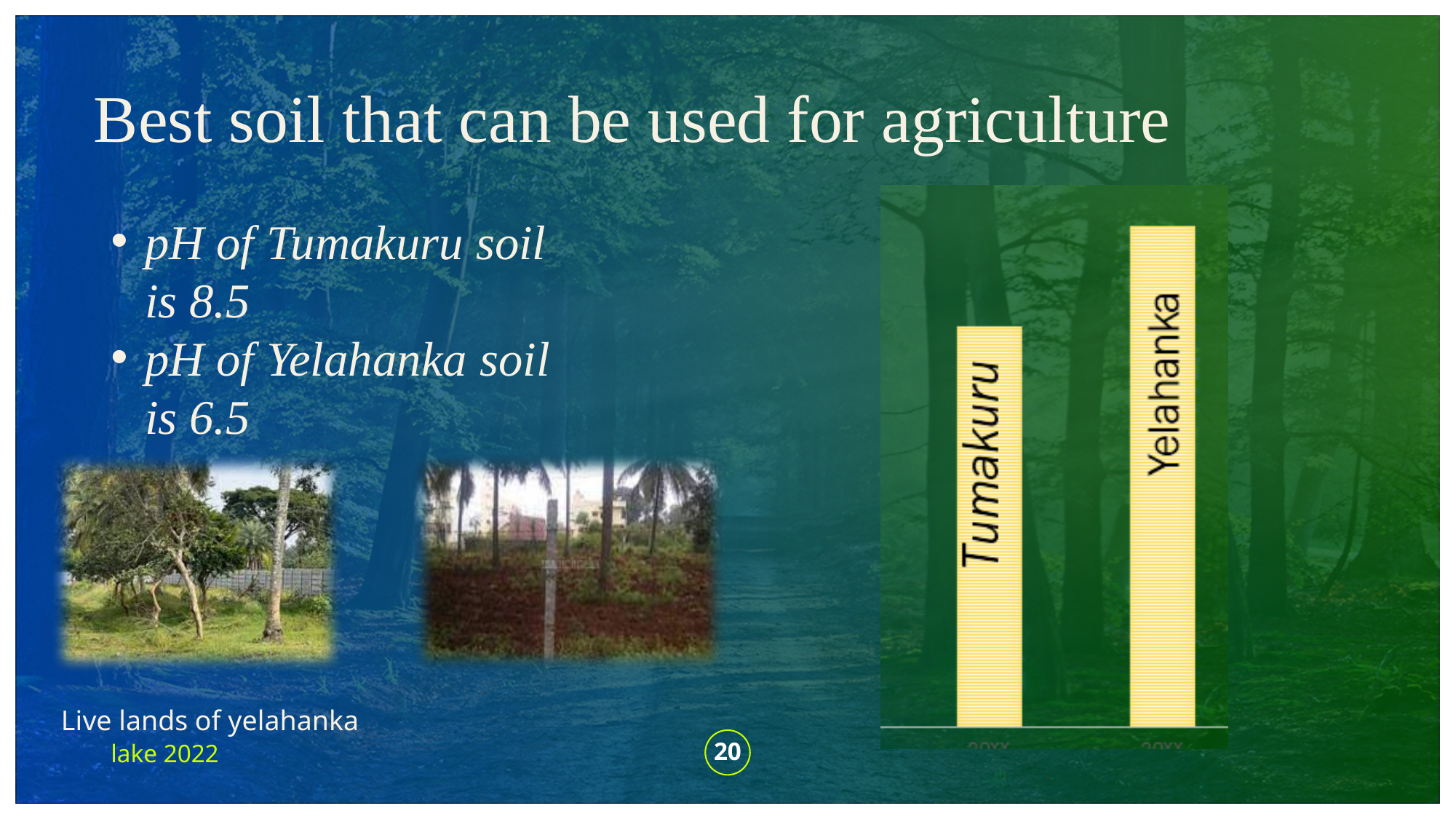
Which two categories are labelled on the bars of the chart? Tumakuru and Yelahanka What colour are the bars in the chart? pale yellow Which bar in the chart is the tallest? Yelahanka What kind of chart is shown on the right side of the slide? bar chart How many bars does the chart on the slide have? 2 In the chart, is the bar for Yelahanka taller or shorter than the bar for Tumakuru? taller Which bar in the chart is the shortest? Tumakuru